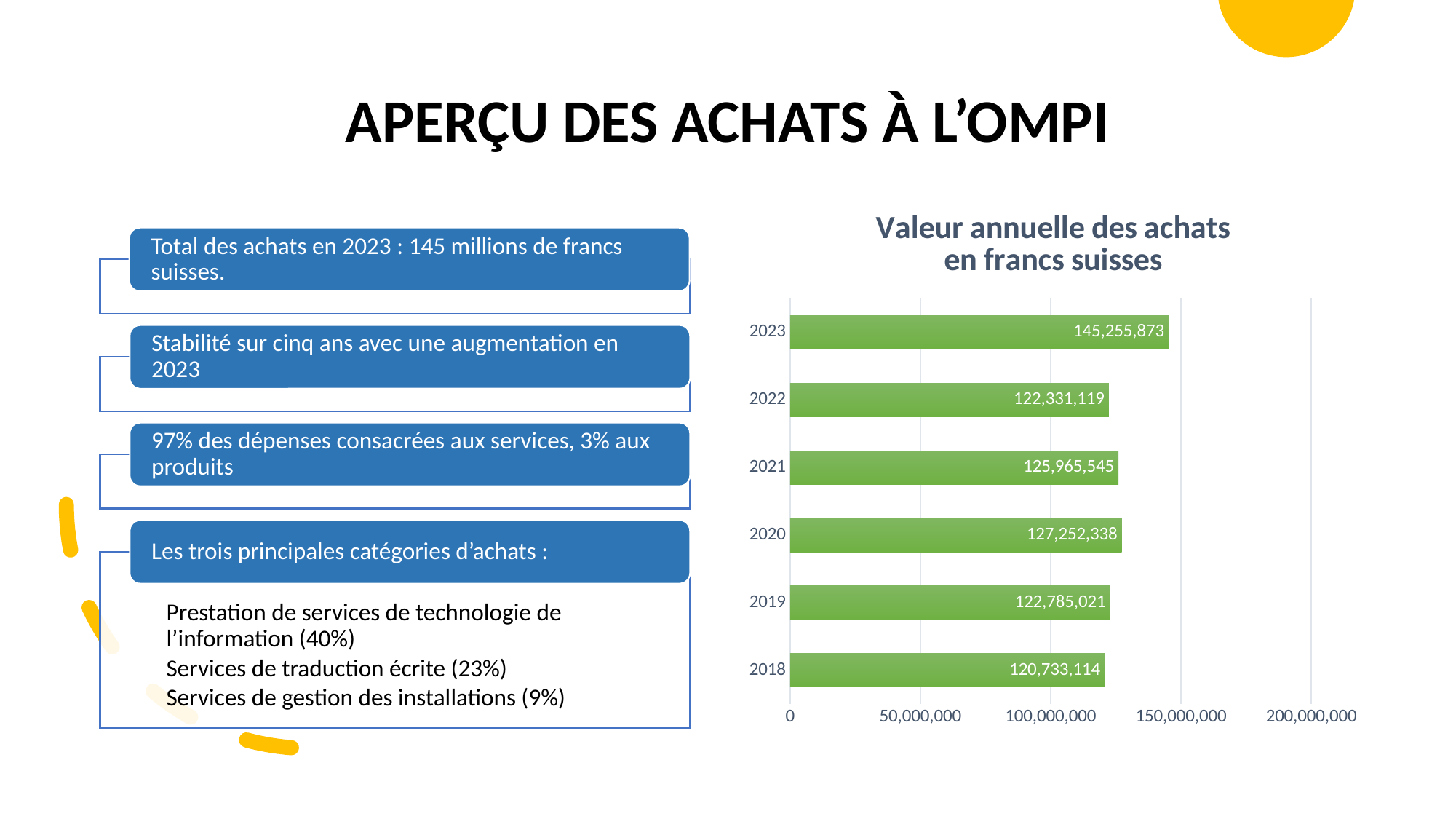
What is the difference between the values for 2023 and 2022? 22,924,754 What is the value for 2018 in the chart? 120,733,114 What is the title of the chart on the slide? Valeur annuelle des achats en francs suisses How many years are shown in the chart? 6 Is the value for 2023 greater or less than 150,000,000? less What is the difference between the values for 2020 and 2021? 1,286,793 What is the value for 2020 in the chart? 127,252,338 What kind of chart is shown on the slide? bar chart What is the value for 2023 in the chart 'Valeur annuelle des achats en francs suisses'? 145,255,873 Which year has the highest value in the chart? 2023 Which year has the lowest value in the chart? 2018 Which is larger, the value for 2021 or the value for 2022? 2021